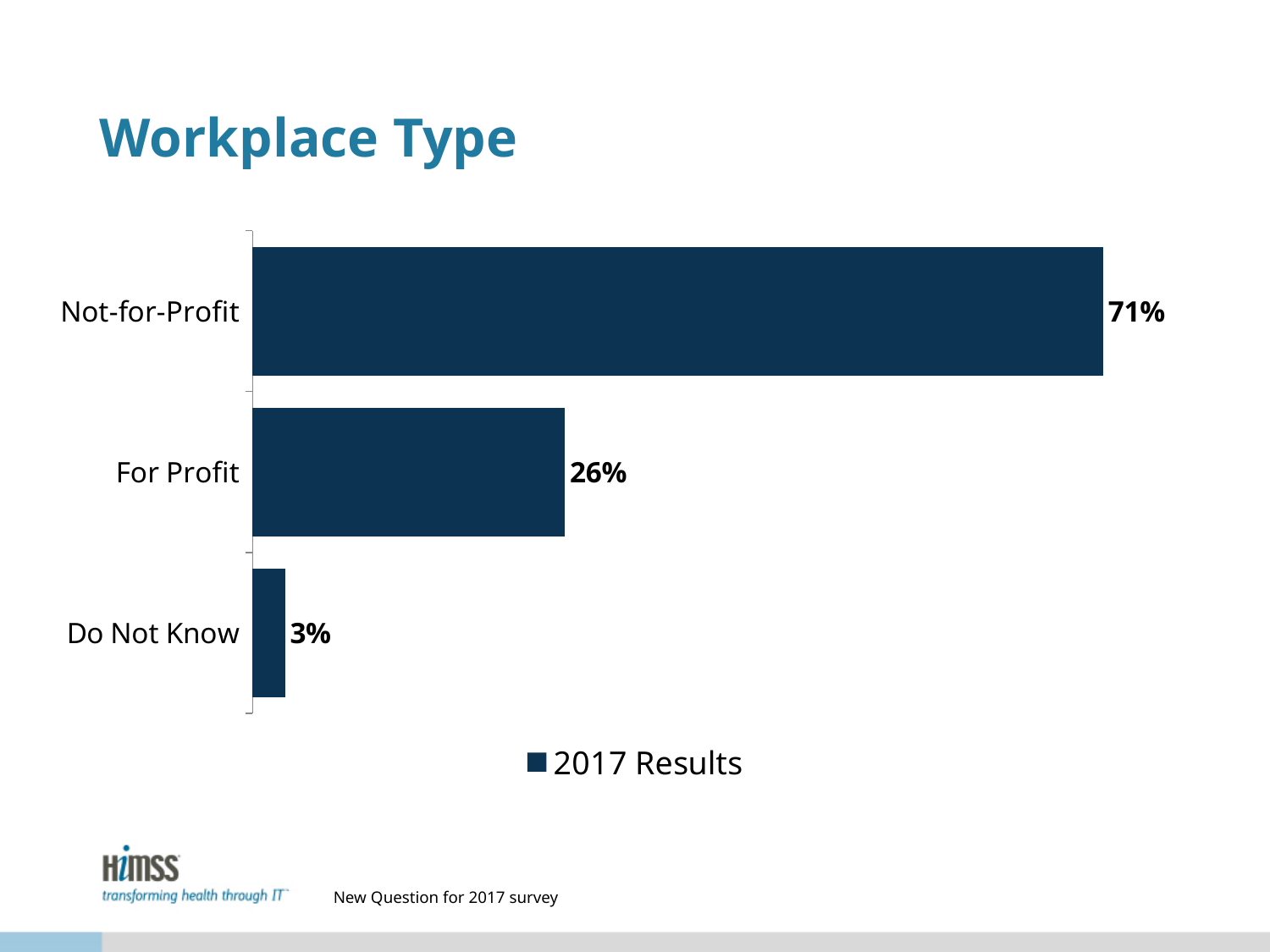
How many series does the legend list? 1 Which workplace type has the highest percentage? Not-for-Profit Which category has the lowest value? Do Not Know What kind of chart is shown on the slide? Bar chart What percentage of respondents work at a Not-for-Profit workplace? 71% What is the name of the series shown in the legend? 2017 Results What is the difference between the Not-for-Profit and For Profit percentages? 45% How much larger is the For Profit value than the Do Not Know value? 23% What percentage of respondents answered Do Not Know? 3% Which is larger, the value for For Profit or the value for Do Not Know? For Profit What is the value shown for For Profit? 26% How many workplace type categories are shown in the chart? 3